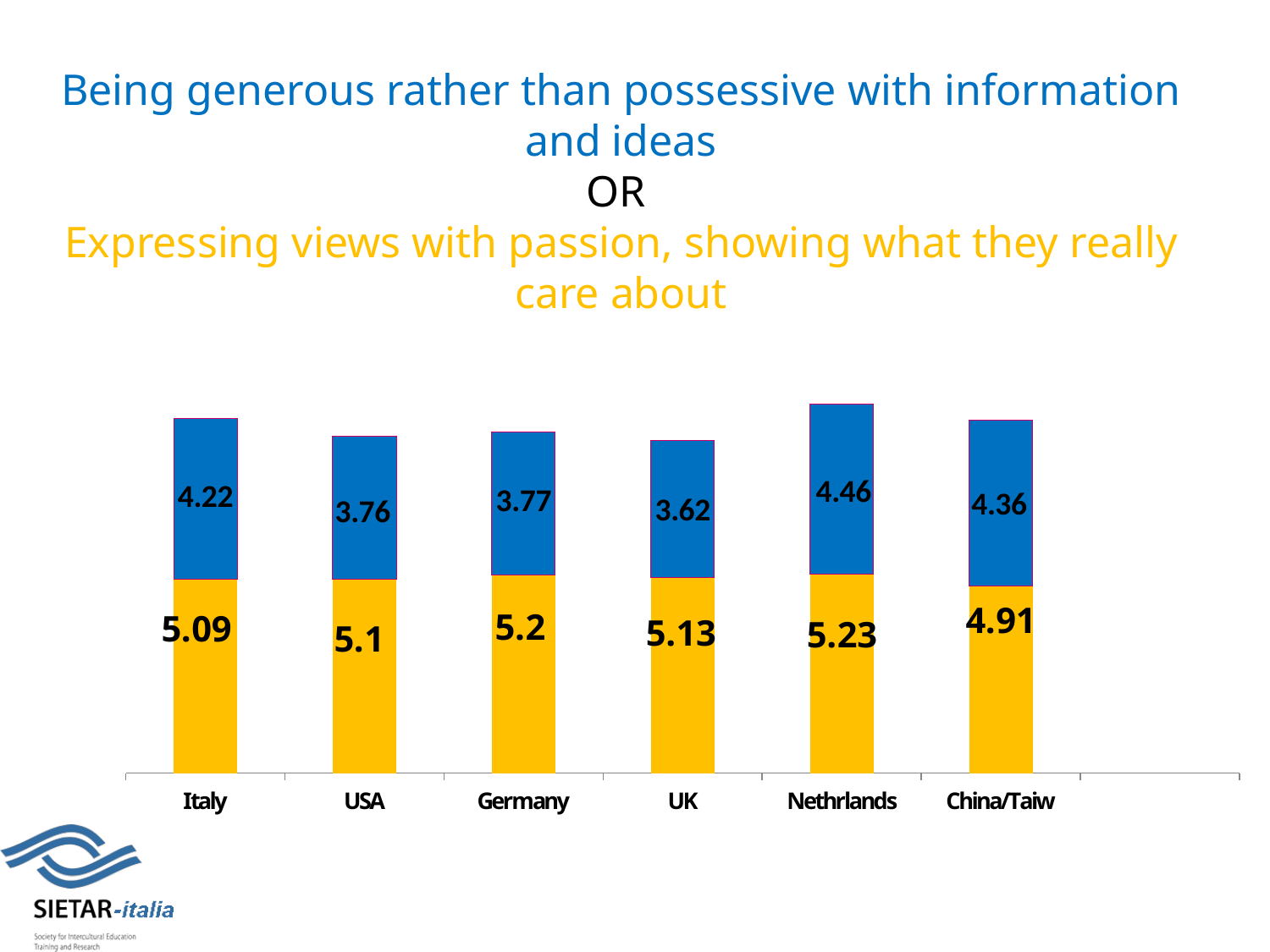
What is the total of the stacked bar for Nethrlands? 9.69 What is the value of the blue segment for Italy? 4.22 What is the value of the blue segment for the UK? 3.62 Which category has the lowest value in the yellow segment? China/Taiw How many categories are shown on the x axis? 6 What kind of chart is shown on the slide? Stacked bar chart What is the total of the stacked bar for Italy? 9.31 What is the value of the yellow segment for Germany? 5.2 Which colour represents 'Expressing views with passion, showing what they really care about'? Yellow Which is larger, the yellow segment for Italy or the yellow segment for USA? USA Which category has the highest value in the blue segment? Nethrlands What is the difference between the blue segment values for Nethrlands and UK? 0.84